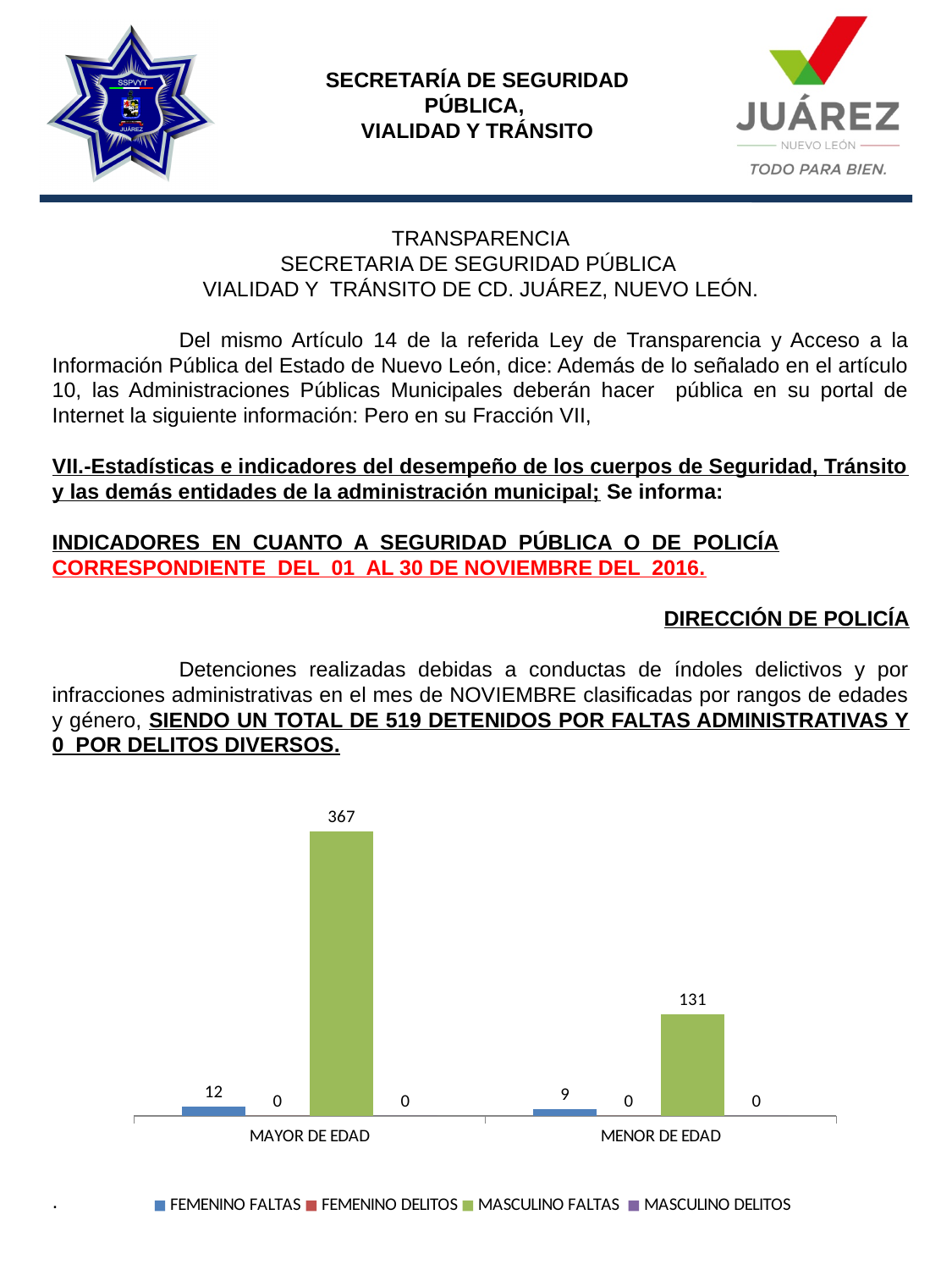
How many categories are shown on the x axis of the chart? 2 What is the value for MASCULINO FALTAS in the MENOR DE EDAD category? 131 What kind of chart is shown on the slide? Bar chart How many series does the chart legend list? 4 Which series has the highest value in the MAYOR DE EDAD category? MASCULINO FALTAS What is the value for FEMENINO FALTAS in the MENOR DE EDAD category? 9 What is the total of all four series for the MENOR DE EDAD category? 140 What is the value for MASCULINO FALTAS in the MAYOR DE EDAD category? 367 What is the difference between MASCULINO FALTAS for MAYOR DE EDAD and MASCULINO FALTAS for MENOR DE EDAD? 236 Which is larger: FEMENINO FALTAS for MAYOR DE EDAD or FEMENINO FALTAS for MENOR DE EDAD? FEMENINO FALTAS for MAYOR DE EDAD What is the value for FEMENINO DELITOS in the MAYOR DE EDAD category? 0 Which colour represents MASCULINO FALTAS in the chart legend? Green